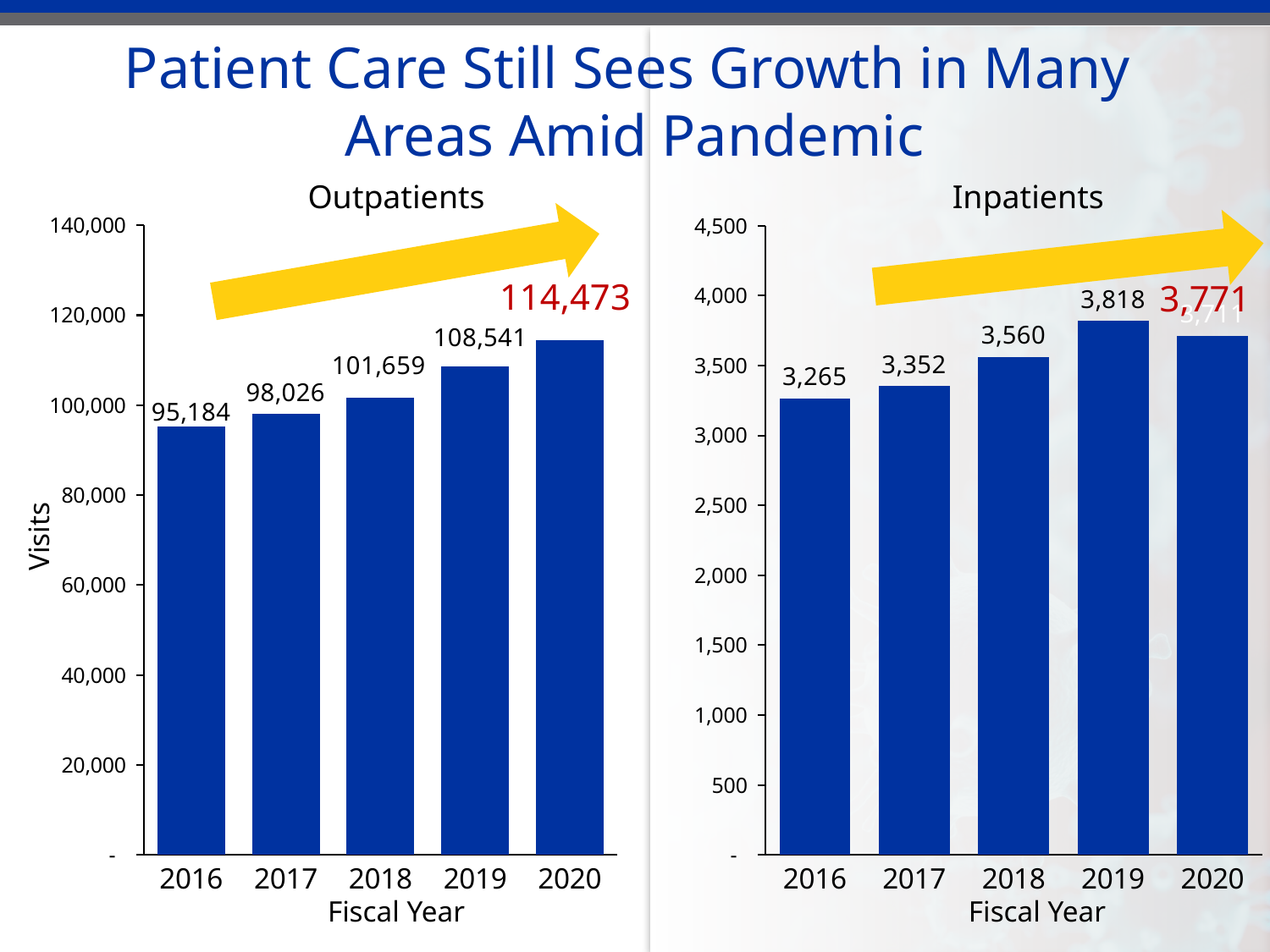
In the Outpatients chart, how many visits were there in fiscal year 2020? 114,473 In the Inpatients chart, which fiscal year has the highest value? 2019 In the Outpatients chart, how many visits were there in fiscal year 2016? 95,184 In the Outpatients chart, is the value for 2018 greater or less than 100,000? greater In the Outpatients chart, do the values rise or fall from 2016 to 2020? rise In the Inpatients chart, which is larger, the value for 2019 or the value for 2020? 2019 In the Inpatients chart, how many visits were there in fiscal year 2018? 3,560 In the Inpatients chart, what is the difference between the 2017 and 2016 values? 87 What kind of chart is the Inpatients chart? bar chart In the Outpatients chart, which fiscal year has the lowest value? 2016 In the Outpatients chart, what is the difference between the 2020 and 2019 values? 5,932 How many fiscal years are shown in the Outpatients chart? 5